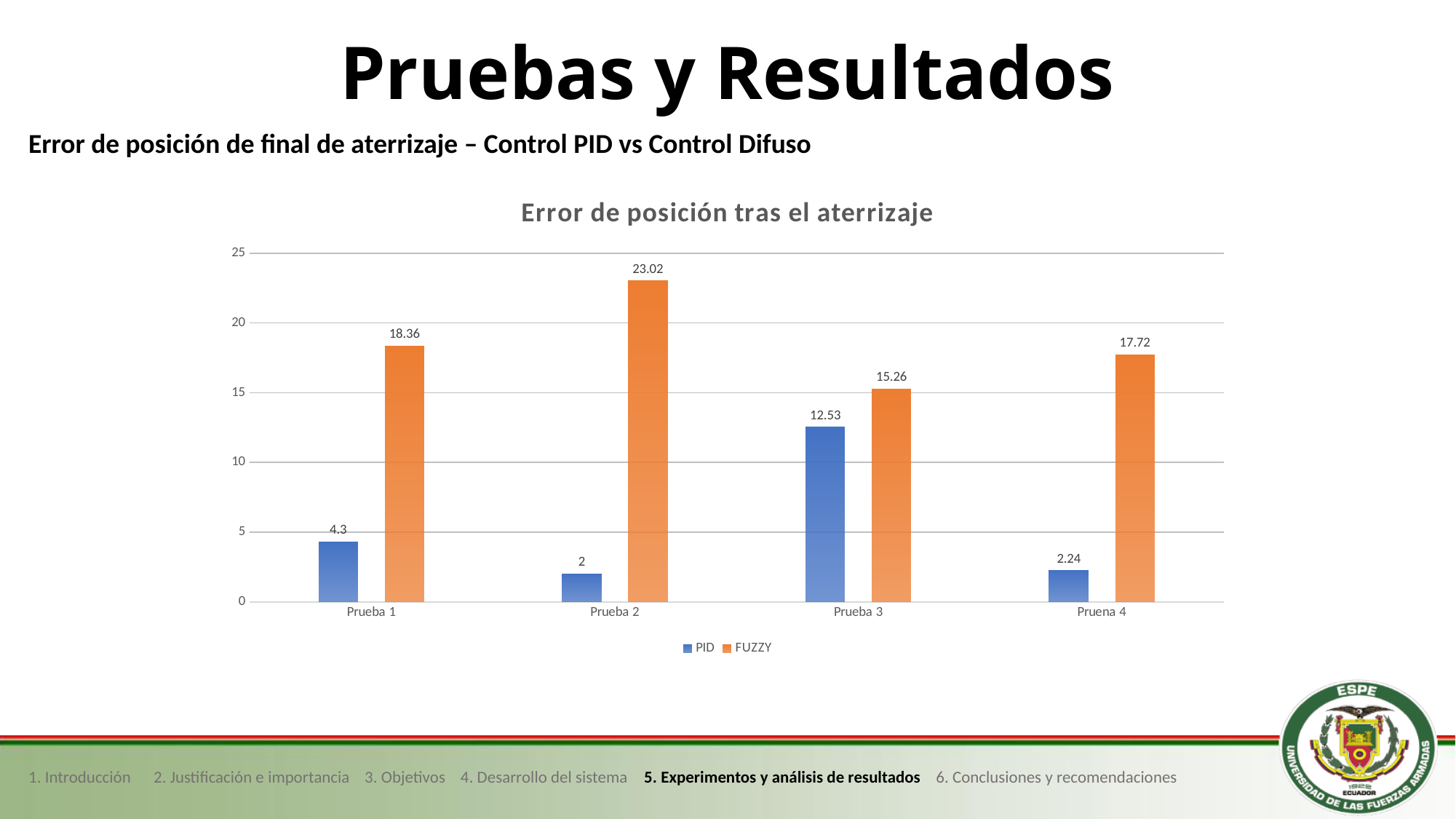
What is the FUZZY value for Pruena 4? 17.72 Which category has the highest FUZZY value? Prueba 2 What is the PID value for Prueba 1? 4.3 What is the title of the chart? Error de posición tras el aterrizaje What is the FUZZY value for Prueba 2? 23.02 What is the difference between the FUZZY and PID values for Prueba 3? 2.73 Which is larger for Prueba 1, the PID value or the FUZZY value? FUZZY What kind of chart is shown on the slide? Bar chart Which category has the lowest PID value? Prueba 2 What is the PID value for Prueba 3? 12.53 How many series does the legend list? 2 How many categories are shown on the x axis? 4